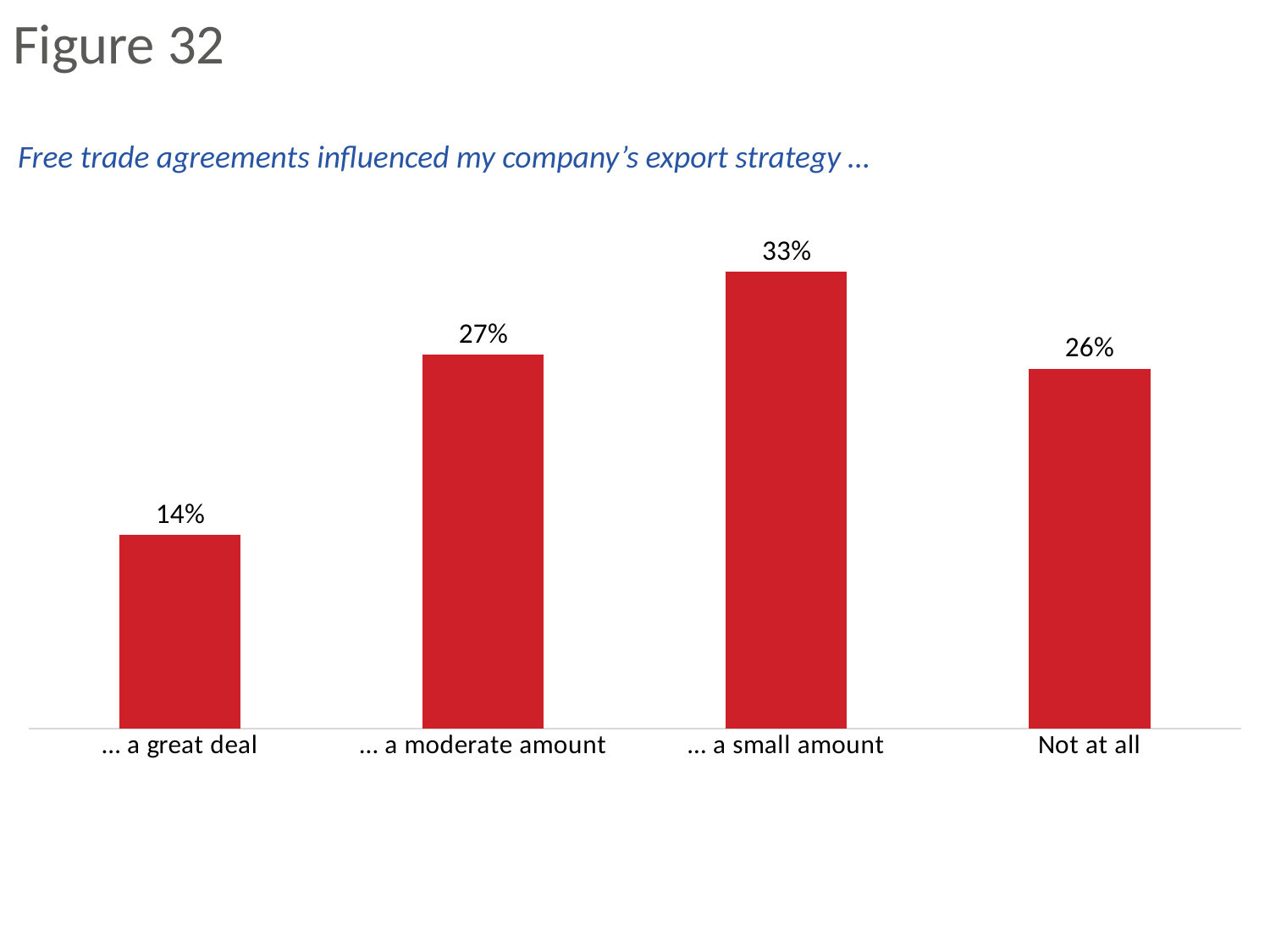
What is the difference between the values for '... a small amount' and '... a great deal'? 19% Which category has the highest value? ... a small amount What is the difference between the values for '... a moderate amount' and 'Not at all'? 1% What is the value for '... a small amount'? 33% How many categories are shown in the chart? 4 What is the value for 'Not at all'? 26% What kind of chart is shown on the slide? Bar chart Which category has the lowest value? ... a great deal What percentage of respondents said free trade agreements influenced their company's export strategy a great deal? 14% Which is larger, the value for '... a moderate amount' or the value for '... a great deal'? ... a moderate amount What is the value for '... a moderate amount'? 27% What statement does the chart's subtitle ask respondents to complete? Free trade agreements influenced my company's export strategy ...